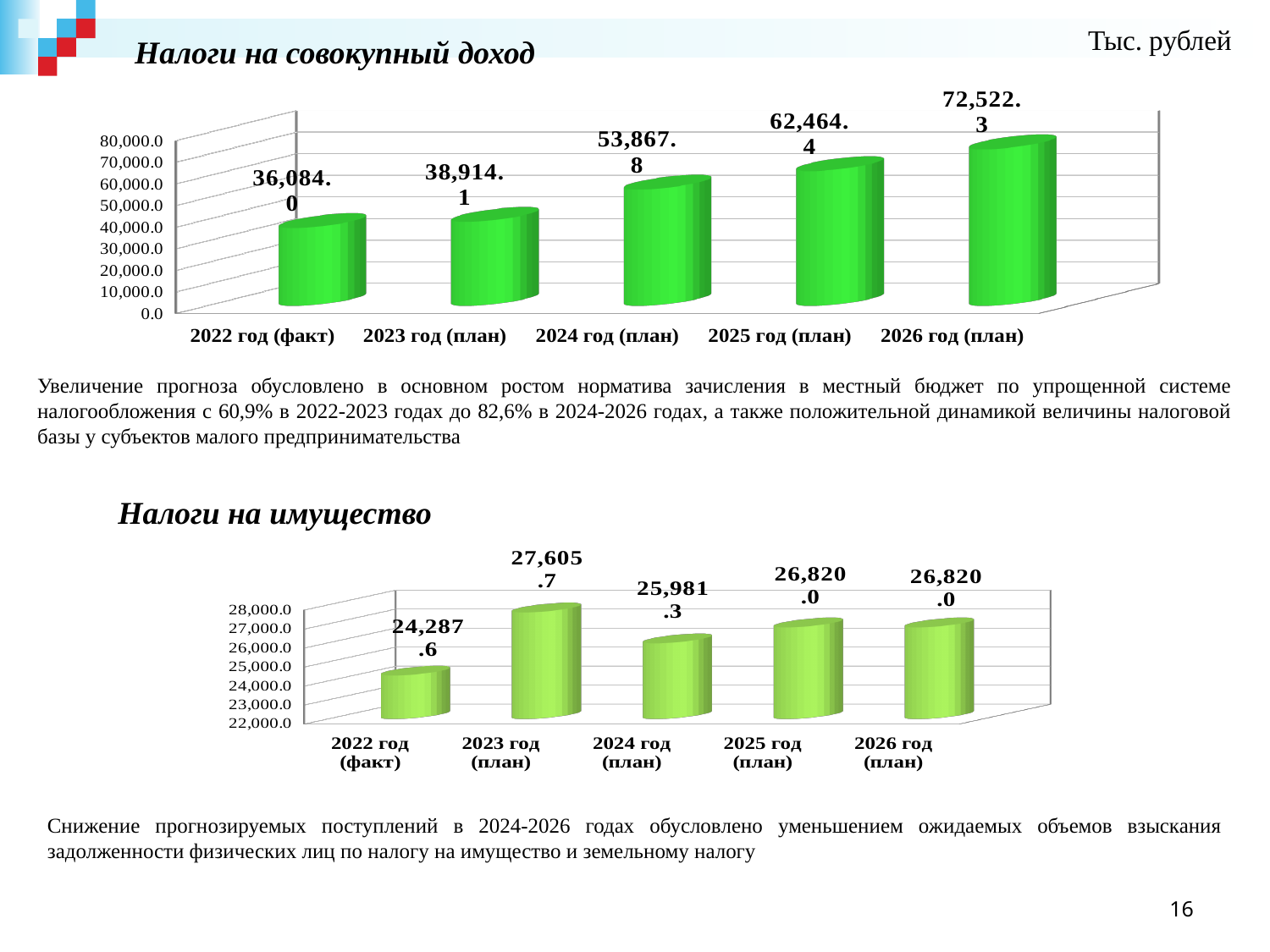
In the 'Налоги на совокупный доход' chart, how many years are shown? 5 In the 'Налоги на имущество' chart, what is the difference between the 2023 год (план) and 2022 год (факт) values? 3,318.1 What type of chart is the 'Налоги на имущество' chart? bar chart In the 'Налоги на совокупный доход' chart, which year has the highest value? 2026 год (план) In the 'Налоги на совокупный доход' chart, what is the value for 2022 год (факт)? 36,084.0 In the 'Налоги на совокупный доход' chart, what is the difference between the 2026 год (план) and 2022 год (факт) values? 36,438.3 In the 'Налоги на имущество' chart, which is larger: the value for 2023 год (план) or 2024 год (план)? 2023 год (план) In the 'Налоги на имущество' chart, which year has the lowest value? 2022 год (факт) In the 'Налоги на имущество' chart, what is the value for 2025 год (план)? 26,820.0 In the 'Налоги на совокупный доход' chart, do the values rise or fall from 2022 to 2026? rise In the 'Налоги на совокупный доход' chart, what is the value for 2024 год (план)? 53,867.8 In the 'Налоги на имущество' chart, what is the value for 2023 год (план)? 27,605.7